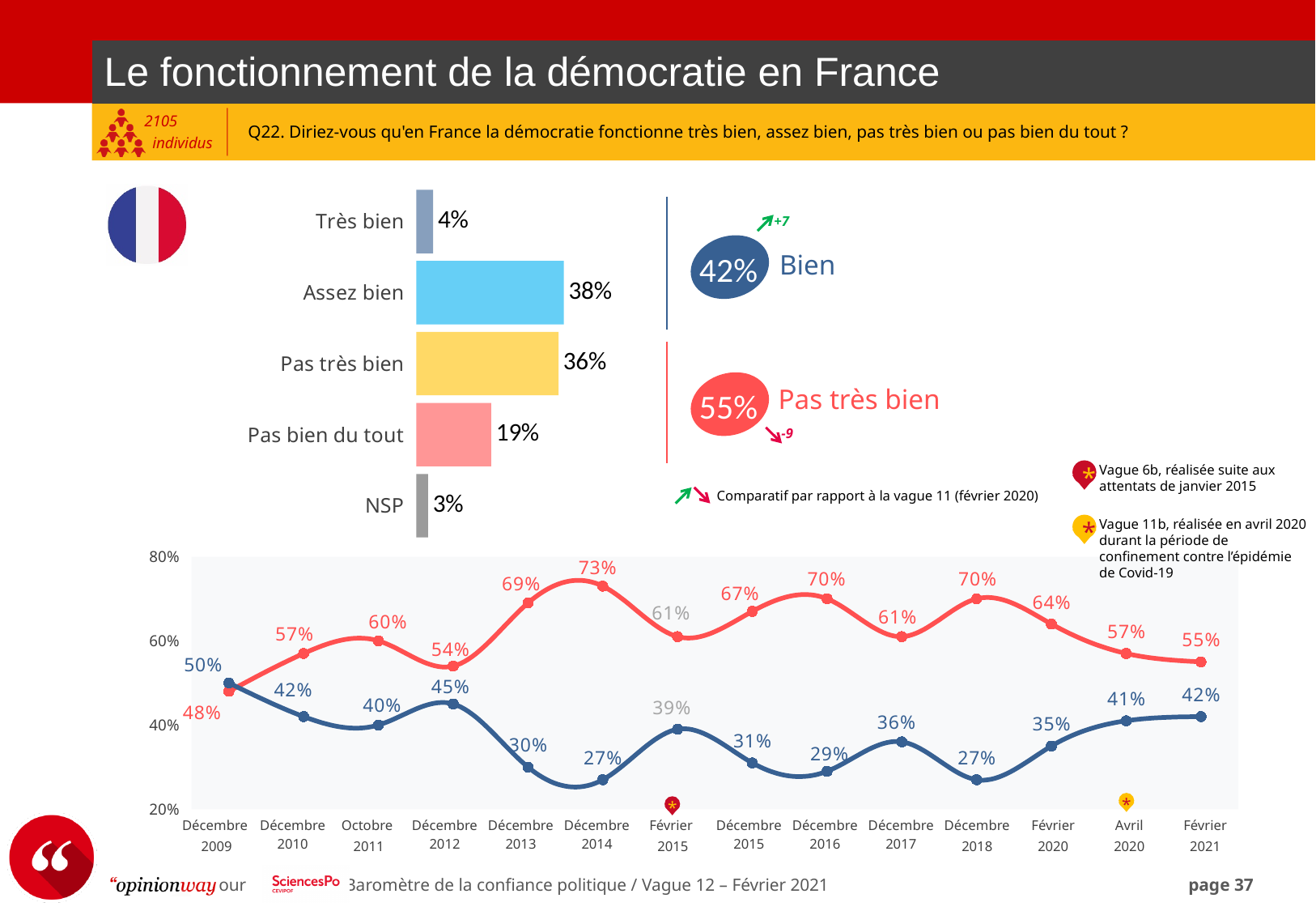
In the bar chart at the top, which category has the lowest value? NSP In the line chart at the bottom, which is larger for Décembre 2009: the blue line or the red line? The blue line (50%) In the line chart at the bottom, how many time points are plotted on the x axis? 14 In the bar chart at the top, which category has the highest value? Assez bien In the line chart at the bottom, at which time point does the red line reach its highest value? Décembre 2014 What kind of chart is the chart at the bottom of the slide? Line chart In the line chart at the bottom, what is the value of the red line for Décembre 2014? 73% In the bar chart at the top, what is the difference between "Pas très bien" and "Pas bien du tout"? 17 percentage points In the line chart at the bottom, what is the value of the blue line for Février 2021? 42% In the bar chart at the top, what is the value for "Assez bien"? 38% In the bar chart at the top, what is the value for "Pas bien du tout"? 19% In the bar chart at the top, how many categories are shown? 5